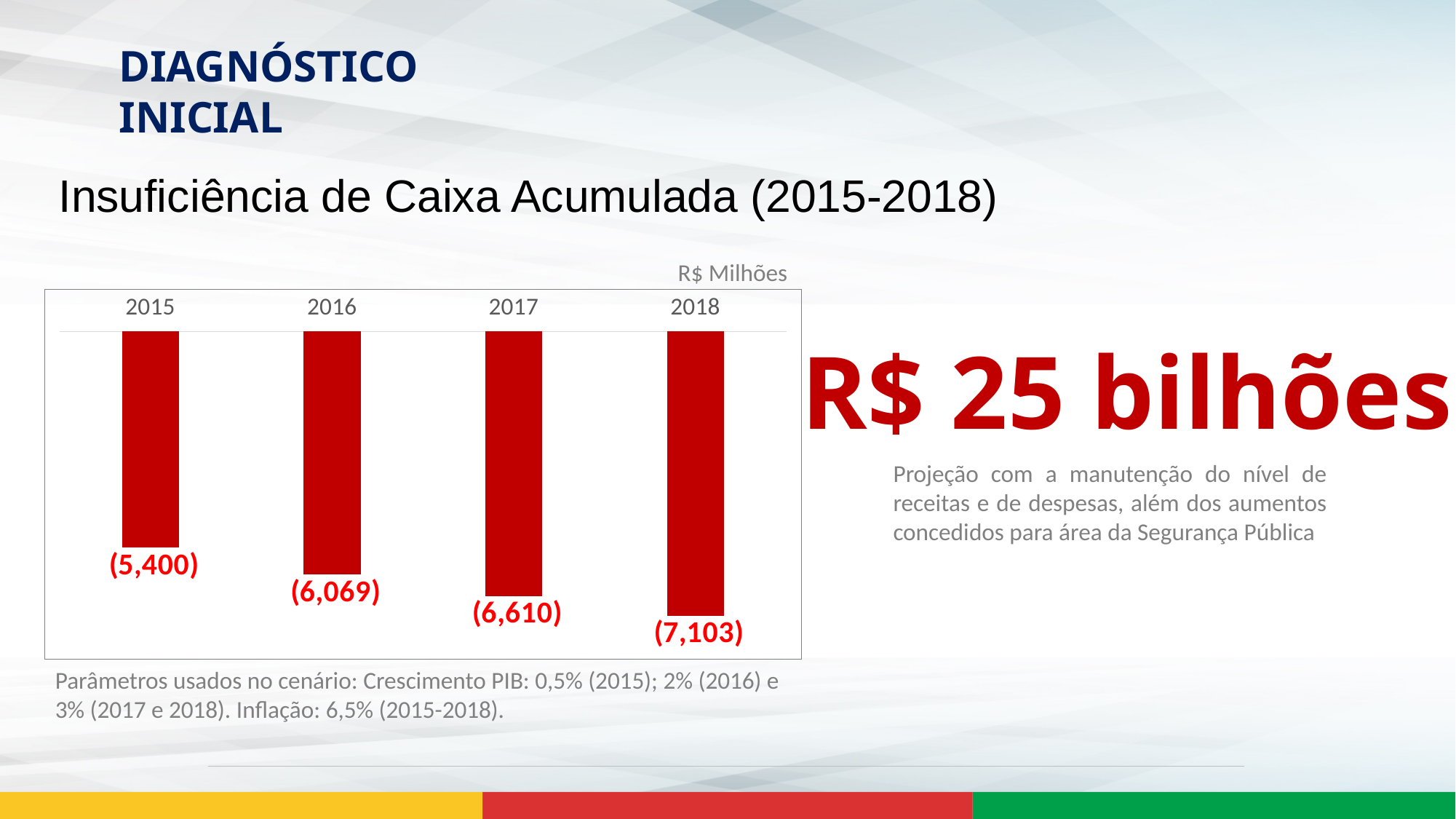
Which year has the smallest cash insufficiency (the shortest bar) in the chart? 2015 By how much does the cash insufficiency for 2016 exceed that of 2015, in R$ millions? 669 What is the value shown for 2016 in the chart? (6,069) Which year has a larger cash insufficiency, 2017 or 2018? 2018 What is the value shown for 2018 in the chart? (7,103) By how much does the cash insufficiency for 2018 exceed that of 2015, in R$ millions? 1,703 What is the value shown for 2017 in the chart? (6,610) Which year has the largest cash insufficiency (the longest bar) in the chart? 2018 Does the cash insufficiency grow or shrink from 2015 to 2018 along the x axis? Grow What type of chart is used on the slide? Bar chart What is the value shown for 2015 in the chart? (5,400) How many years are plotted in the chart? 4